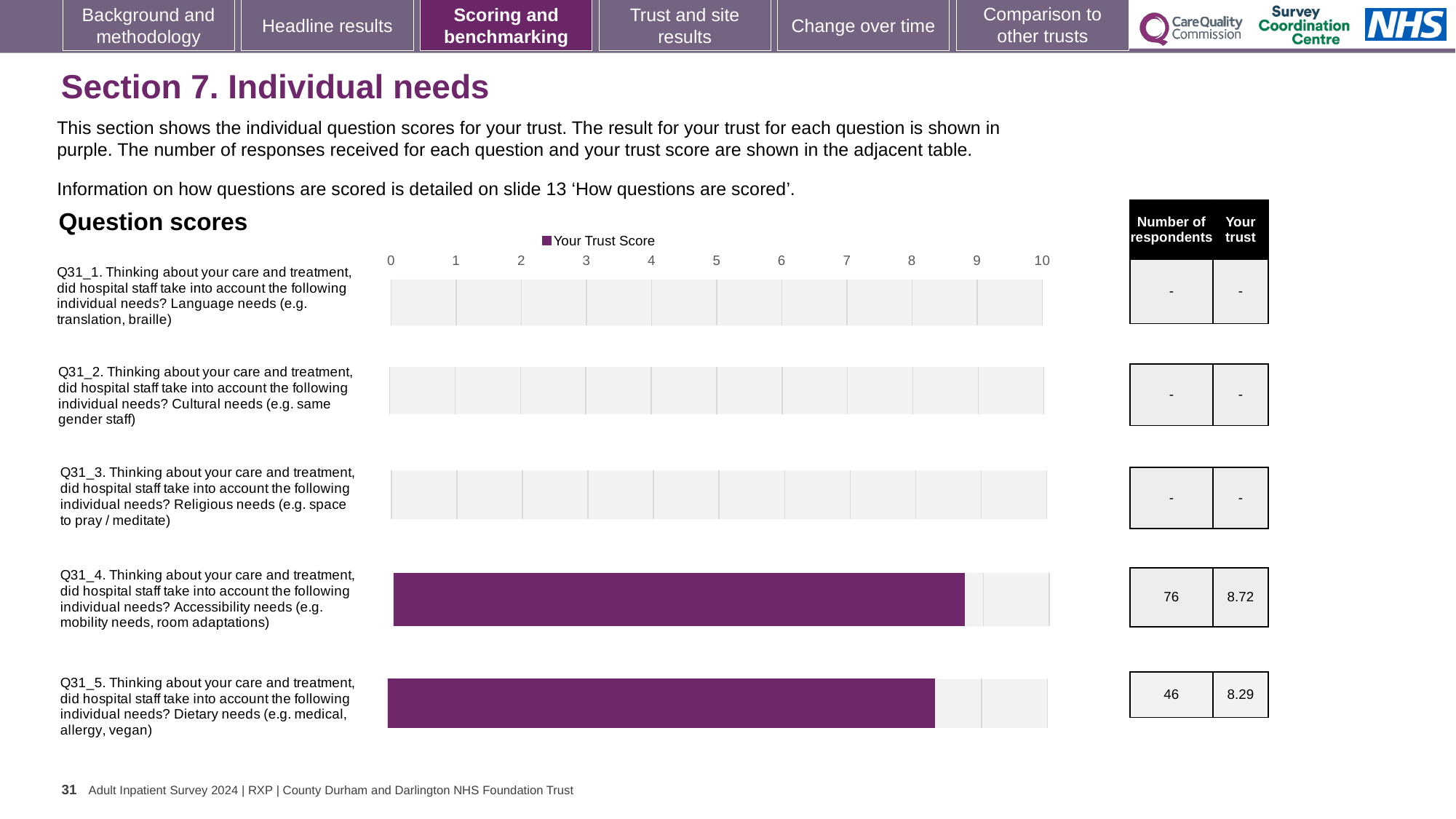
What is the trust score for Q31_4 (Accessibility needs)? 8.72 Which has the larger trust score, Q31_4 (Accessibility needs) or Q31_5 (Dietary needs)? Q31_4 (Accessibility needs) Which question has the highest plotted trust score? Q31_4 (Accessibility needs) What kind of chart is used to show the question scores? Bar chart How many respondents answered Q31_4 (Accessibility needs)? 76 What is the difference between the trust scores for Q31_4 and Q31_5? 0.43 Is the trust score for Q31_5 (Dietary needs) greater or less than 9? less How many questions are listed in the Question scores chart? 5 How many series does the chart legend list? 1 How many respondents answered Q31_5 (Dietary needs)? 46 Is the trust score for Q31_4 (Accessibility needs) greater or less than 8? greater What is the trust score for Q31_5 (Dietary needs)? 8.29